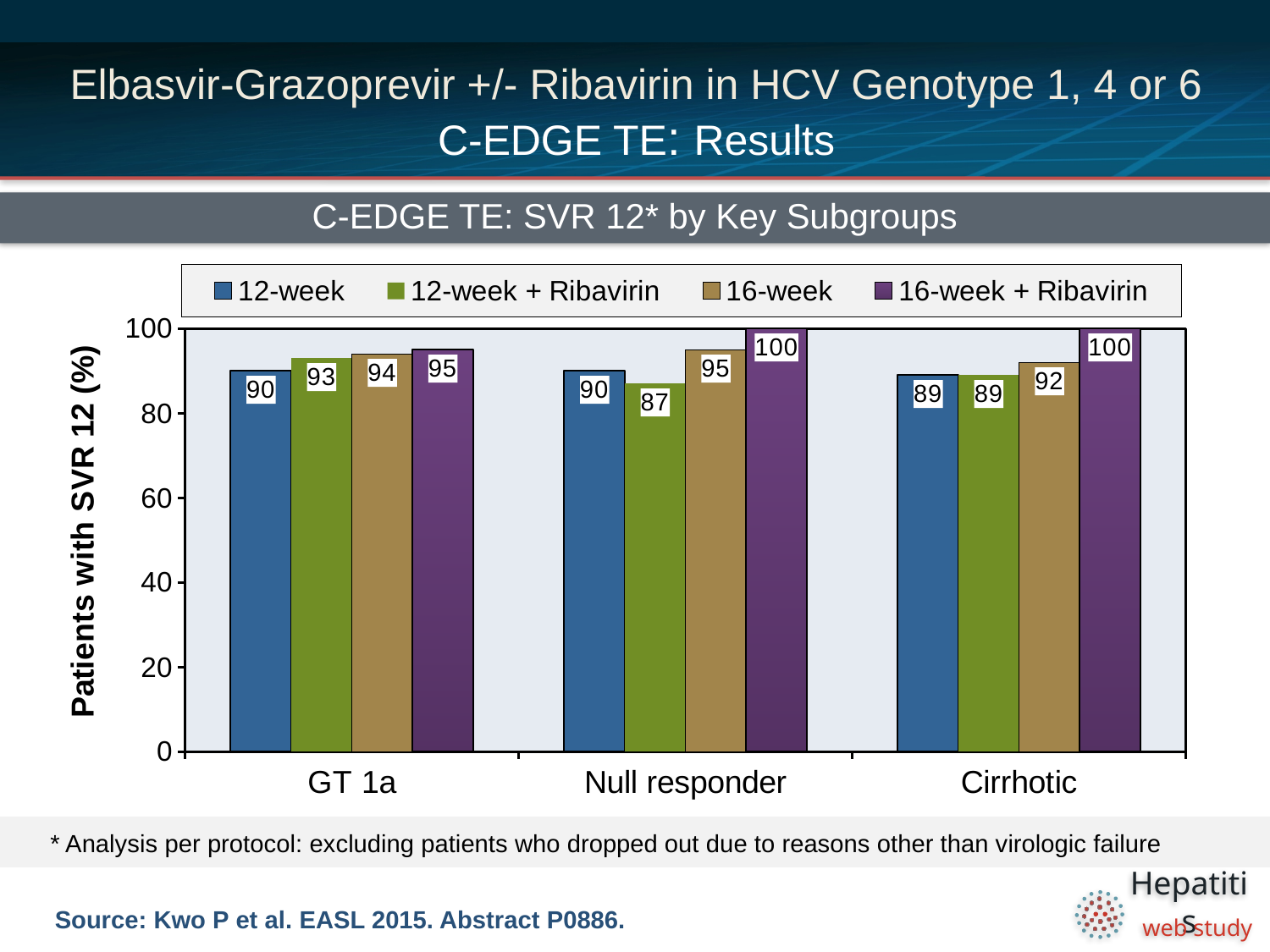
How many series does the legend list? 4 How many subgroup categories are shown on the x axis? 3 What is the label of the y axis? Patients with SVR 12 (%) What is the SVR 12 value for the 16-week series in the Cirrhotic group? 92 Which series has the lowest SVR 12 value in the GT 1a group? 12-week What is the SVR 12 value for the 12-week + Ribavirin series in the Null responder group? 87 What kind of chart is shown on the slide? Bar chart What is the SVR 12 value for the 12-week series in the GT 1a group? 90 What is the title of the chart? C-EDGE TE: SVR 12* by Key Subgroups Which is larger: the 16-week value for GT 1a or the 16-week value for Cirrhotic? GT 1a What is the difference between the 16-week + Ribavirin and 12-week + Ribavirin values in the Null responder group? 13 Which series has the highest SVR 12 value in the Null responder group? 16-week + Ribavirin